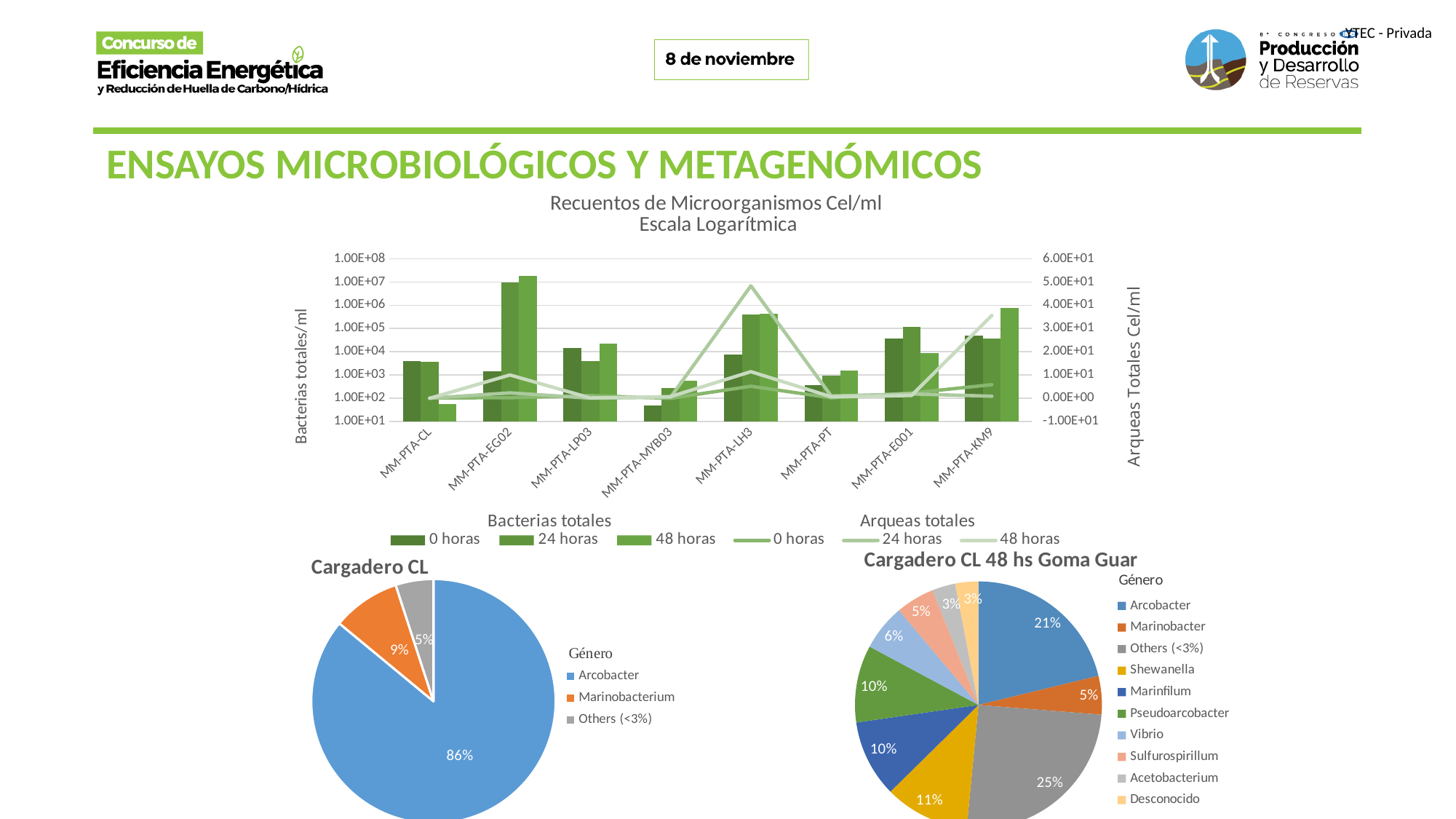
In the 'Cargadero CL 48 hs Goma Guar' pie chart, which genus has the largest slice? Others (<3%) In the 'Cargadero CL 48 hs Goma Guar' pie chart, what share does Others (<3%) have? 25% In the 'Cargadero CL' pie chart, how many slices are listed in the legend? 3 In the 'Cargadero CL 48 hs Goma Guar' pie chart, what share does Shewanella have? 11% In the 'Recuentos de Microorganismos Cel/ml' chart, is the 48 horas Bacterias totales value for MM-PTA-EG02 greater or less than 1.00E+07? greater In the 'Cargadero CL 48 hs Goma Guar' pie chart, how many genera are listed in the legend? 10 In the 'Cargadero CL 48 hs Goma Guar' pie chart, what is the difference between the Arcobacter share and the Vibrio share? 15% In the 'Cargadero CL' pie chart, what share does Marinobacterium have? 9% In the 'Recuentos de Microorganismos Cel/ml' chart, how many series does the legend list in total? 6 In the 'Recuentos de Microorganismos Cel/ml' chart, how many sample categories are shown on the x axis? 8 In the 'Cargadero CL 48 hs Goma Guar' pie chart, which is larger, the Pseudoarcobacter slice or the Sulfurospirillum slice? Pseudoarcobacter